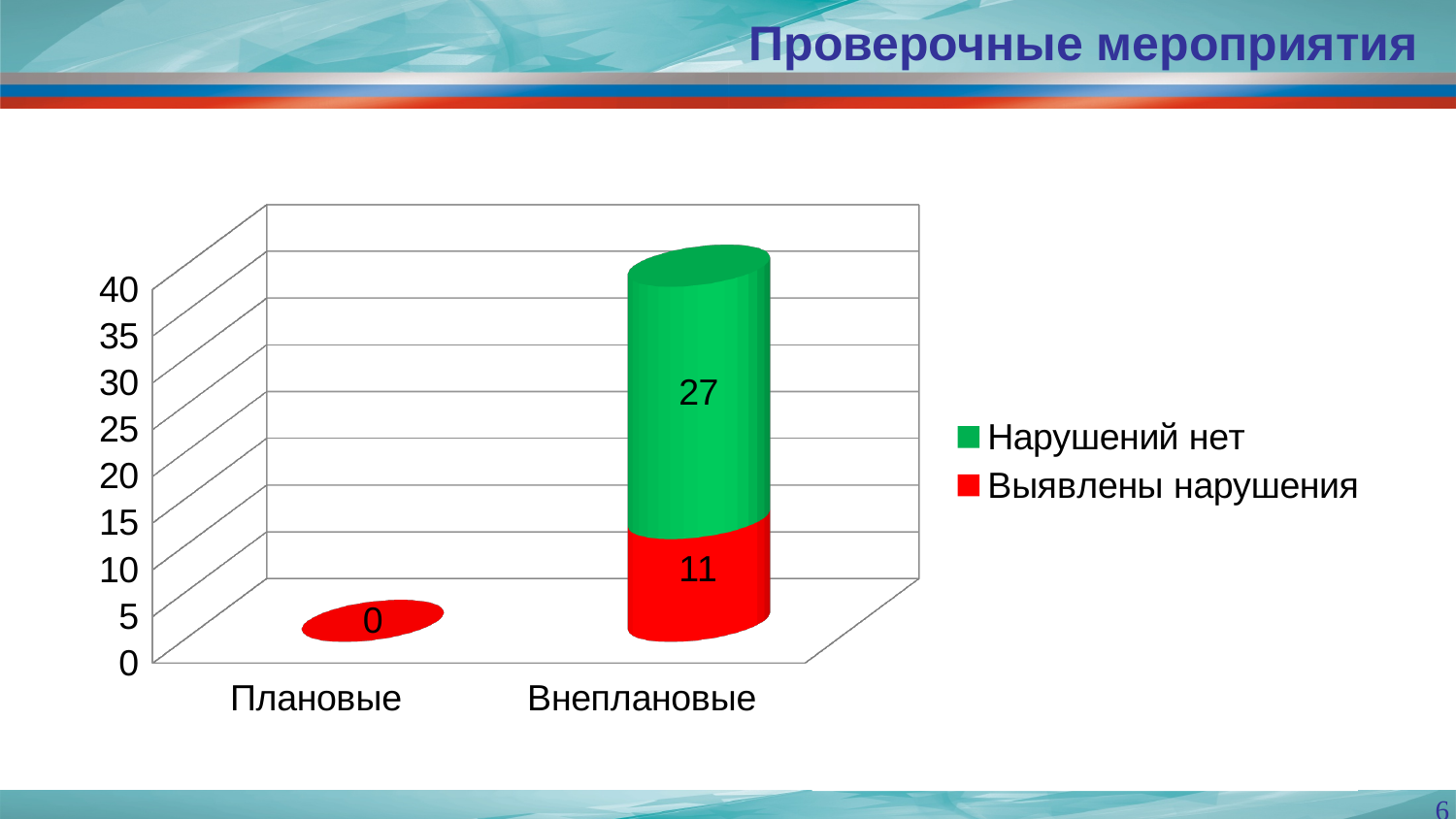
How many series does the legend list? 2 Which category has the highest total bar? Внеплановые What is the difference between "Нарушений нет" and "Выявлены нарушения" for "Внеплановые"? 16 For "Внеплановые", which is larger: "Нарушений нет" or "Выявлены нарушения"? Нарушений нет What is the value for "Выявлены нарушения" in the "Внеплановые" category? 11 Which category has the lowest total bar? Плановые What kind of chart is shown on the slide? Stacked bar chart What is the value for "Нарушений нет" in the "Внеплановые" category? 27 What is the total of the stacked bar for "Внеплановые"? 38 How many categories are shown on the x axis? 2 Which colour represents "Выявлены нарушения" in the legend? Red What is the value for "Выявлены нарушения" in the "Плановые" category? 0